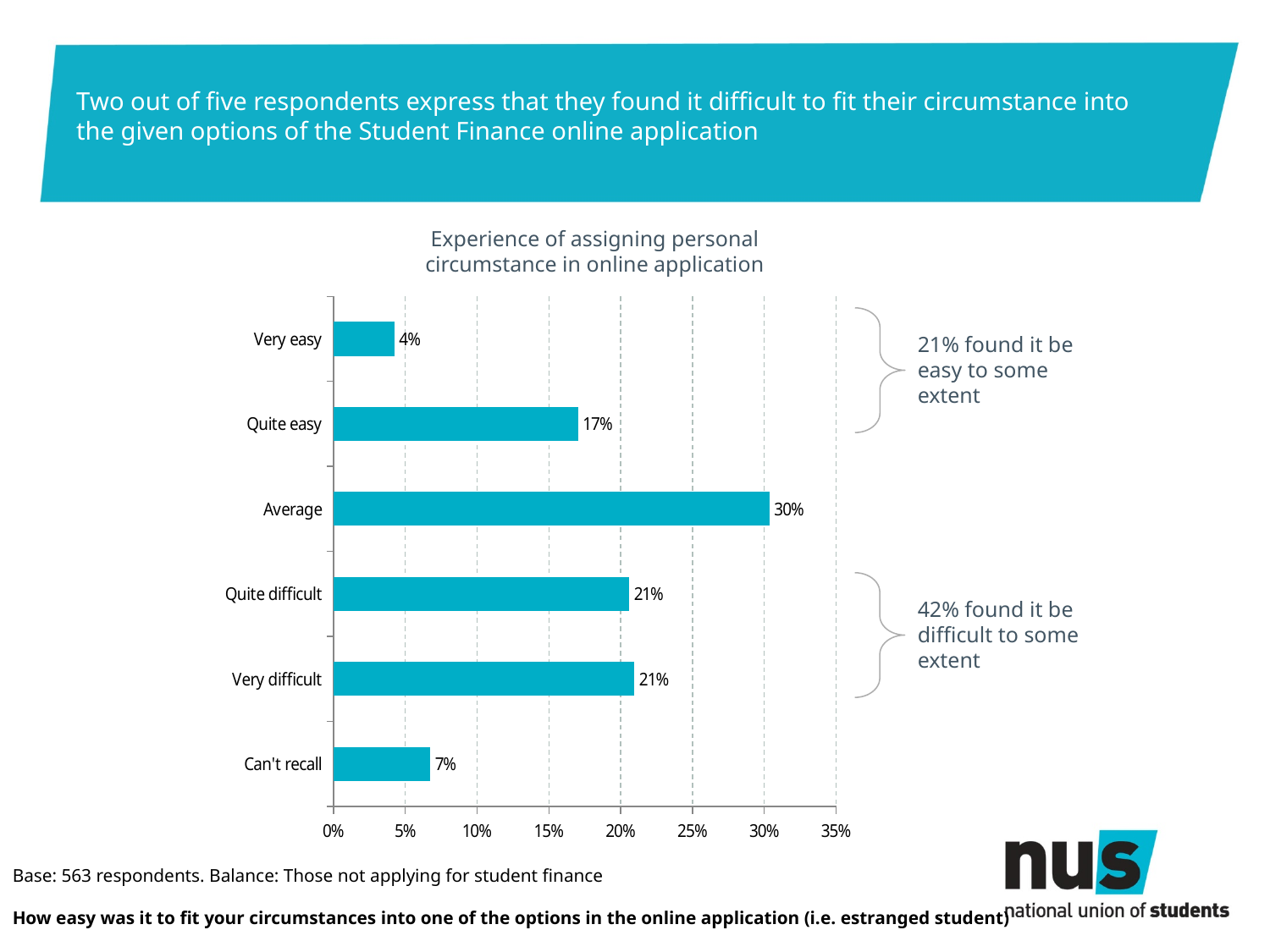
What is the value for Can't recall? 7% What is the value for Very easy? 4% Is the value for Average greater or less than 25%? greater Which category has the highest value? Average Which category has the lowest value? Very easy Which is larger, the value for Quite easy or the value for Quite difficult? Quite difficult How many categories are shown on the chart? 6 What kind of chart is shown on the slide? Bar chart What is the value for Average? 30% What is the combined value for Quite difficult and Very difficult? 42% What is the title of the chart? Experience of assigning personal circumstance in online application What is the difference between the values for Average and Quite easy? 13%